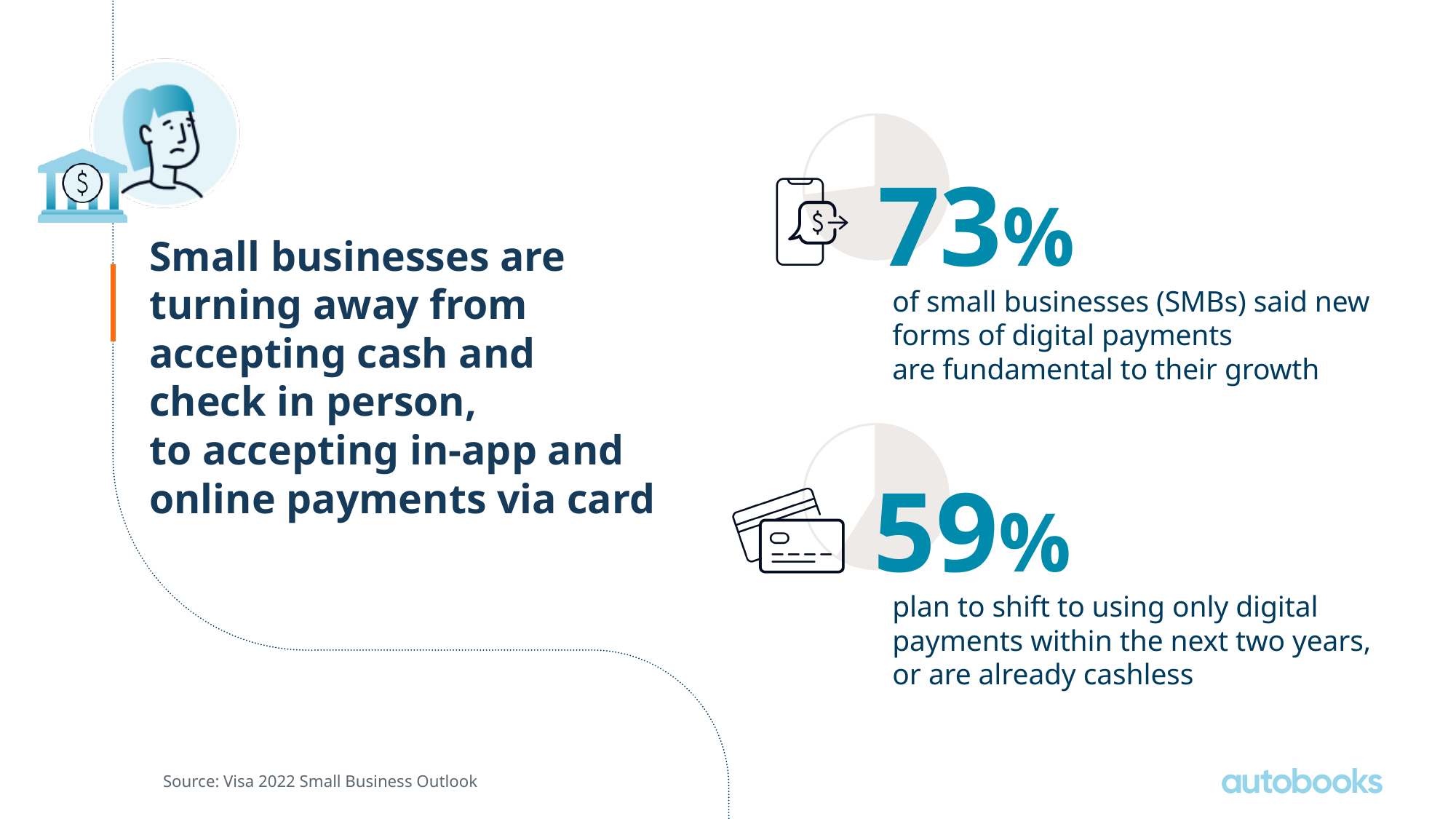
What percentage of small businesses plan to shift to using only digital payments within the next two years, or are already cashless? 59% Is the share of SMBs that said digital payments are fundamental to their growth greater or less than 75%? less What kind of chart graphic accompanies each statistic on the right side of the slide? Pie chart What is the difference in percentage points between the 73% statistic and the 59% statistic? 14 percentage points What percentage of small businesses said new forms of digital payments are fundamental to their growth? 73% What is the source cited for the statistics on the slide? Visa 2022 Small Business Outlook Which statistic is larger: the share of SMBs saying digital payments are fundamental to growth, or the share planning to shift to only digital payments? The share saying digital payments are fundamental to growth (73%) Is the share of SMBs that plan to shift to only digital payments greater or less than 50%? greater Which statistic is shown in the upper pie chart graphic, 73% or 59%? 73% How many pie-style chart graphics are shown on the slide? 2